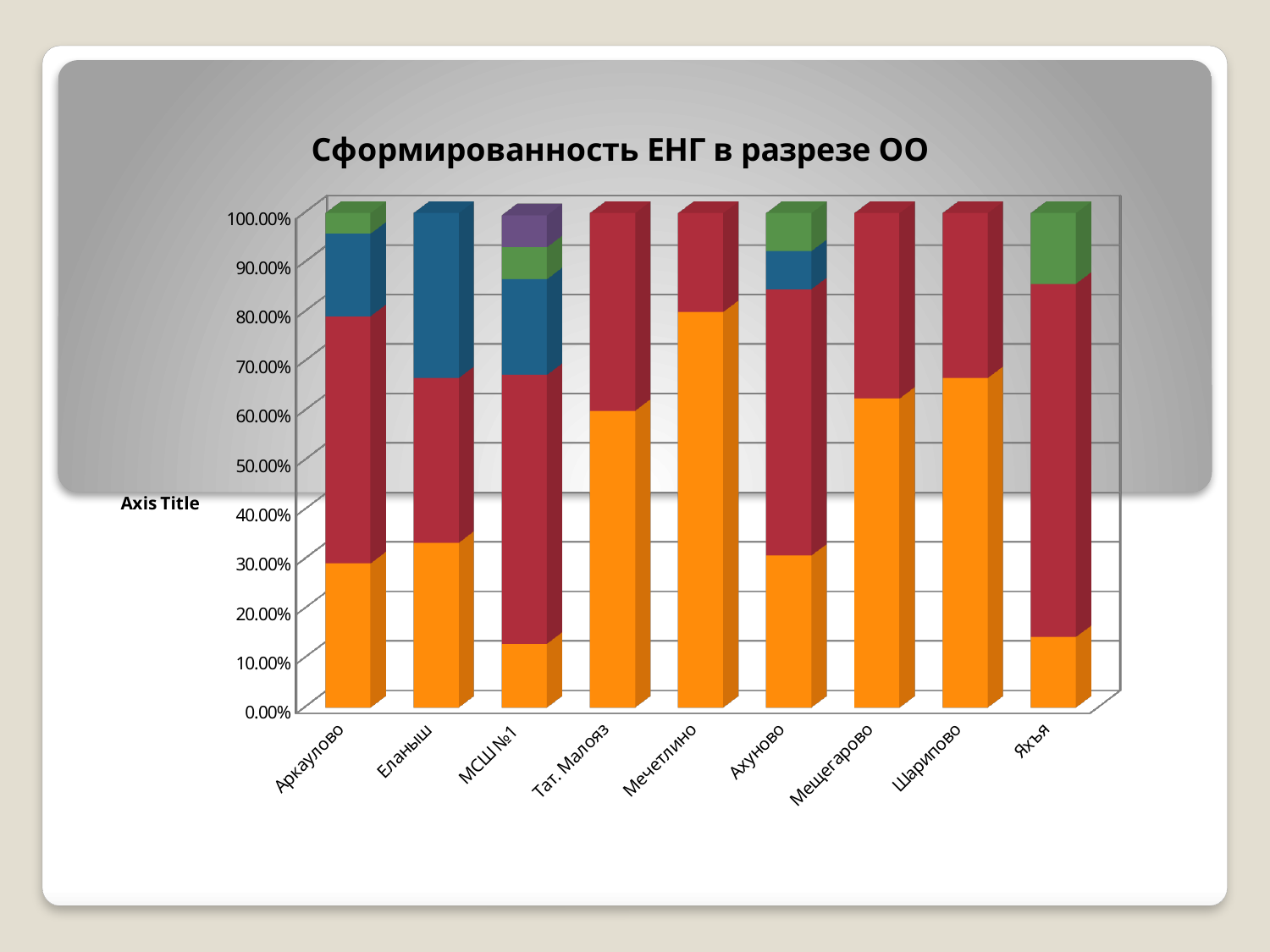
Which has a larger orange (bottom) segment, Мечетлино or МСШ №1? Мечетлино Is the orange (bottom) segment for Яхъя greater or less than 10.00%? greater Which category has the largest orange (bottom) segment? Мечетлино Is the orange (bottom) segment for Шарипово greater or less than 50.00%? greater How many segments make up the stacked bar for МСШ №1? 5 Which category's bar contains a purple segment? МСШ №1 What is the title of the chart? Сформированность ЕНГ в разрезе ОО Is the orange (bottom) segment for МСШ №1 greater or less than 20.00%? less What kind of chart is shown on the slide? stacked bar chart How many categories are shown on the x axis of the chart? 9